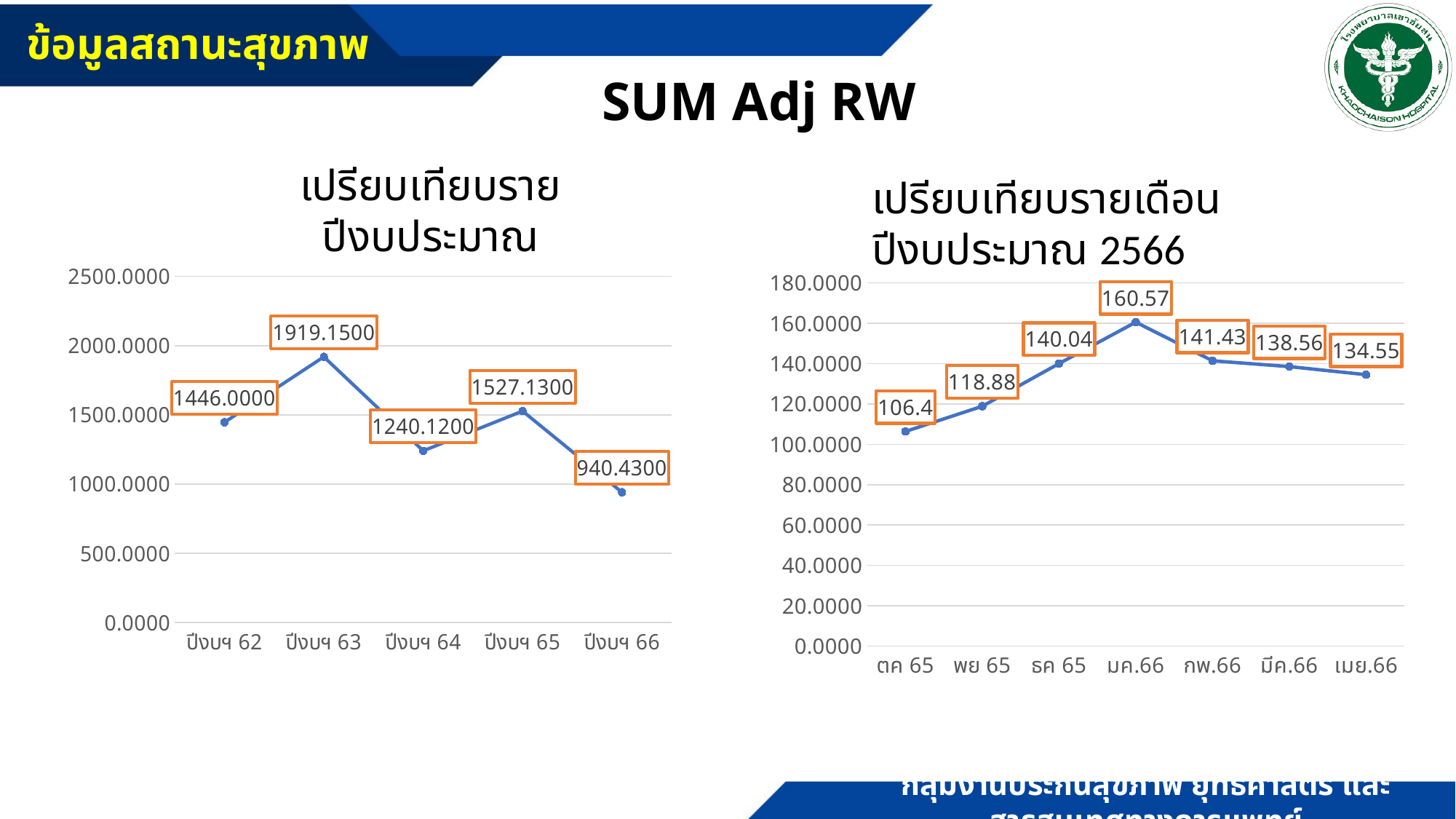
In the left chart (เปรียบเทียบรายปีงบประมาณ), how many fiscal years are plotted? 5 What type of chart is the right chart (เปรียบเทียบรายเดือนปีงบประมาณ 2566)? Line chart In the right chart (เปรียบเทียบรายเดือนปีงบประมาณ 2566), how many months are plotted? 7 In the left chart (เปรียบเทียบรายปีงบประมาณ), what is the difference between the values for ปีงบฯ 63 and ปีงบฯ 64? 679.0300 In the right chart (เปรียบเทียบรายเดือนปีงบประมาณ 2566), which month has the highest value? มค.66 In the left chart (เปรียบเทียบรายปีงบประมาณ), which fiscal year has the lowest value? ปีงบฯ 66 In the left chart (เปรียบเทียบรายปีงบประมาณ), what is the value for ปีงบฯ 63? 1919.1500 In the right chart (เปรียบเทียบรายเดือนปีงบประมาณ 2566), which is larger, the value for ธค 65 or the value for เมย.66? ธค 65 In the left chart (เปรียบเทียบรายปีงบประมาณ), which fiscal year has the highest value? ปีงบฯ 63 In the right chart (เปรียบเทียบรายเดือนปีงบประมาณ 2566), what is the value for มค.66? 160.57 In the left chart (เปรียบเทียบรายปีงบประมาณ), what is the value for ปีงบฯ 66? 940.4300 In the right chart (เปรียบเทียบรายเดือนปีงบประมาณ 2566), what is the value for ตค 65? 106.4